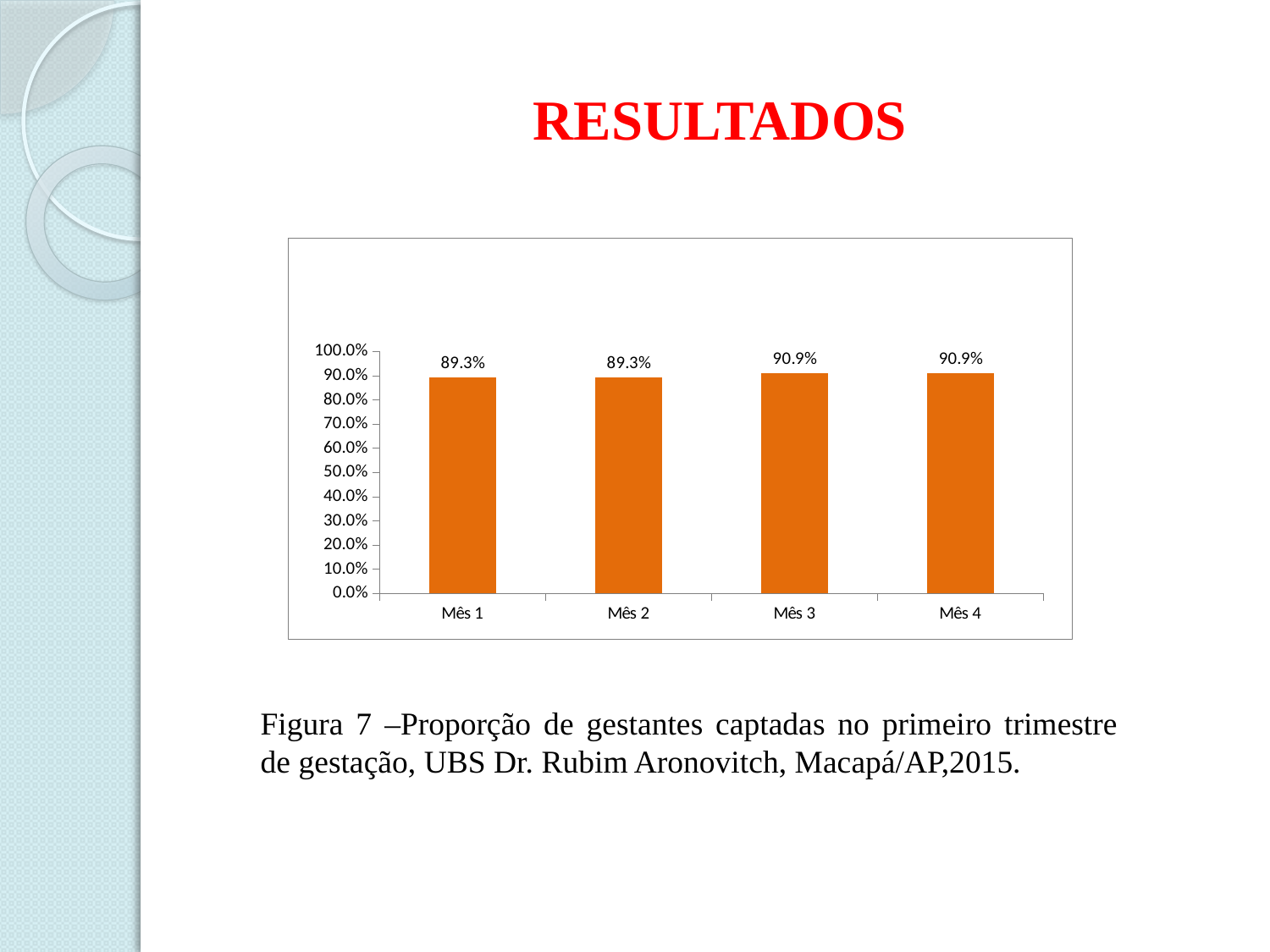
What is the value for Mês 1? 89.3% What is the value for Mês 2? 89.3% What is the title of the slide? RESULTADOS How many categories are shown on the x axis? 4 Is the value for Mês 2 greater or less than 80.0%? greater What is the difference between the values for Mês 3 and Mês 1? 1.6% Do the values rise or fall from Mês 2 to Mês 3? Rise What is the value for Mês 3? 90.9% Is the value for Mês 4 greater or less than 100.0%? less What colour are the bars in the chart? Orange What is the value for Mês 4? 90.9% What kind of chart is shown on the slide? Bar chart